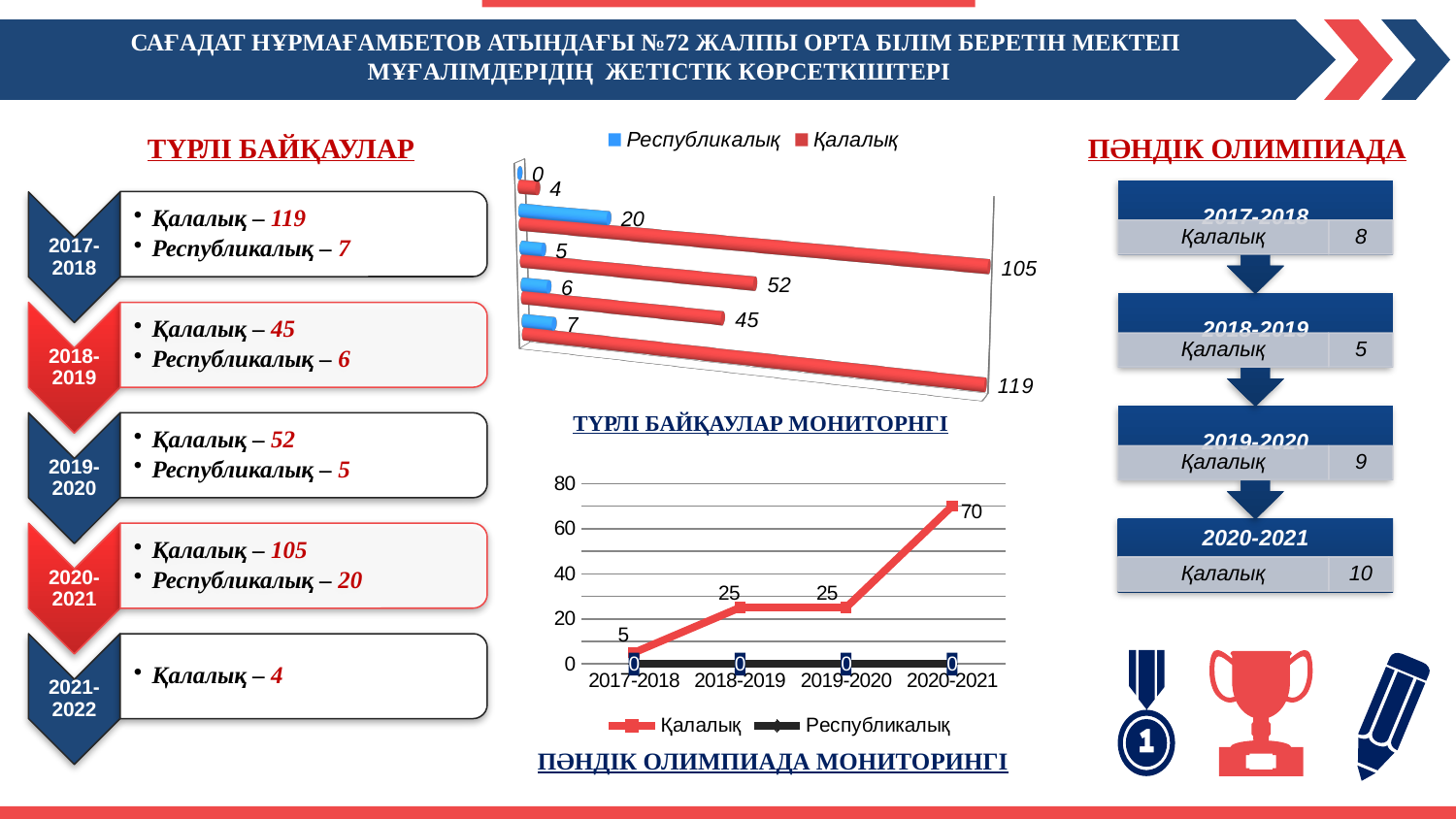
In the chart titled ПӘНДІК ОЛИМПИАДА МОНИТОРИНГІ, what kind of chart is it? line chart In the chart titled ТҮРЛІ БАЙҚАУЛАР МОНИТОРНГІ, what is the largest Қалалық value shown? 119 In the chart titled ПӘНДІК ОЛИМПИАДА МОНИТОРИНГІ, what is the Республикалық value for 2019-2020? 0 In the chart titled ПӘНДІК ОЛИМПИАДА МОНИТОРИНГІ, what is the Қалалық value for 2017-2018? 5 In the chart titled ТҮРЛІ БАЙҚАУЛАР МОНИТОРНГІ, what kind of chart is it? bar chart In the chart titled ПӘНДІК ОЛИМПИАДА МОНИТОРИНГІ, which year has the highest Қалалық value? 2020-2021 In the chart titled ПӘНДІК ОЛИМПИАДА МОНИТОРИНГІ, does the Қалалық line rise or fall from 2017-2018 to 2020-2021? rise In the chart titled ПӘНДІК ОЛИМПИАДА МОНИТОРИНГІ, how many years are shown on the x axis? 4 In the chart titled ПӘНДІК ОЛИМПИАДА МОНИТОРИНГІ, what is the difference between the Қалалық values for 2020-2021 and 2019-2020? 45 In the chart titled ПӘНДІК ОЛИМПИАДА МОНИТОРИНГІ, what is the Қалалық value for 2020-2021? 70 In the chart titled ТҮРЛІ БАЙҚАУЛАР МОНИТОРНГІ, what is the largest Республикалық value shown? 20 In the chart titled ТҮРЛІ БАЙҚАУЛАР МОНИТОРНГІ, how many series does the legend list? 2